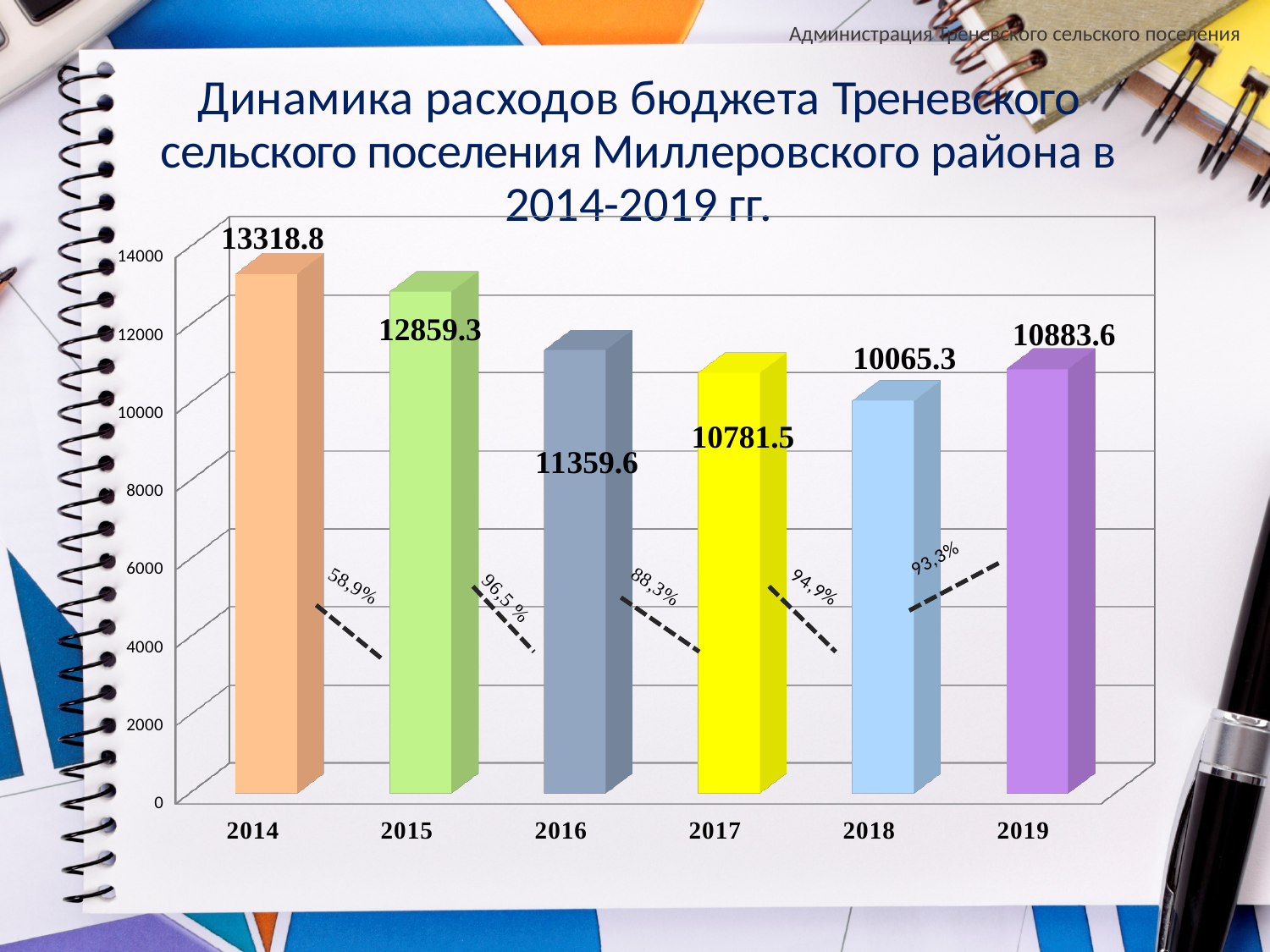
What kind of chart is shown on the slide? bar chart What is the value for 2014? 13318.8 What is the difference between the values for 2014 and 2015? 459.5 Which is larger, the value for 2016 or the value for 2018? 2016 What percentage label is shown between the 2014 and 2015 bars? 58,9% What is the value for 2018? 10065.3 How many years are shown on the x axis? 6 What is the value for 2019? 10883.6 Is the value for 2017 greater or less than 12000? less Which year has the highest value? 2014 Which year has the lowest value? 2018 What is the difference between the values for 2019 and 2018? 818.3